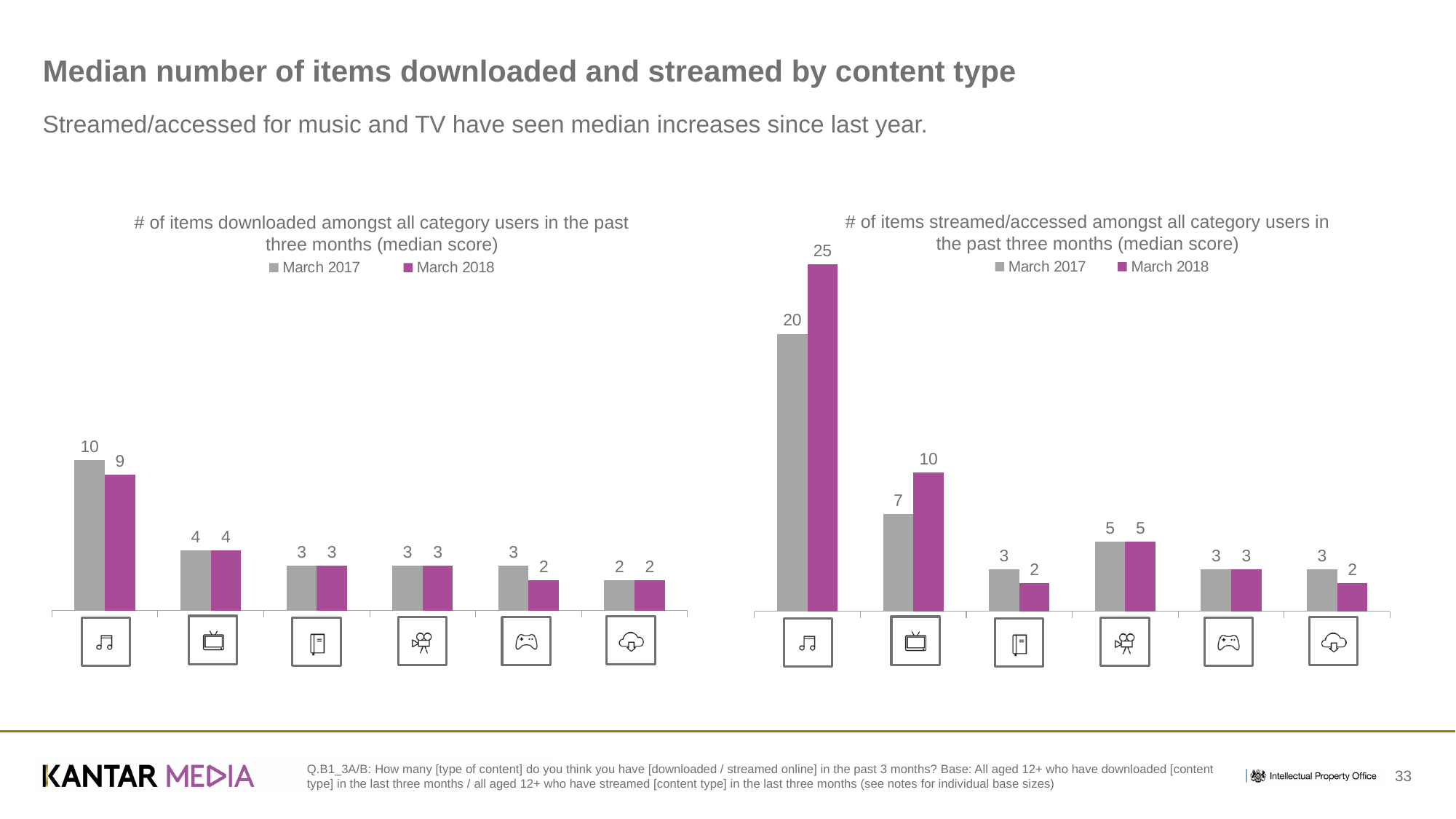
In the left chart (# of items downloaded), which is larger for the fifth category (game controller icon): the March 2017 value or the March 2018 value? March 2017 In the right chart (# of items streamed/accessed), what is the difference between the March 2018 and March 2017 values for the second category (TV icon)? 3 In the left chart (# of items downloaded), what is the March 2017 value for the first category from the left (music note icon)? 10 In the left chart (# of items downloaded), what is the March 2018 value for the first category from the left (music note icon)? 9 How many series does the legend of the right chart (# of items streamed/accessed) list? 2 In the right chart (# of items streamed/accessed), which category has the highest March 2018 value? The first category (music note icon) In the right chart (# of items streamed/accessed), what is the difference between the March 2018 and March 2017 values for the first category (music note icon)? 5 In the right chart (# of items streamed/accessed), what is the March 2018 value for the first category from the left (music note icon)? 25 In the right chart (# of items streamed/accessed), what colour are the March 2018 bars? Purple In the right chart (# of items streamed/accessed), what is the March 2017 value for the second category from the left (TV icon)? 7 What type of chart is the left chart (# of items downloaded)? Bar chart How many categories are shown on the x axis of the left chart (# of items downloaded)? 6